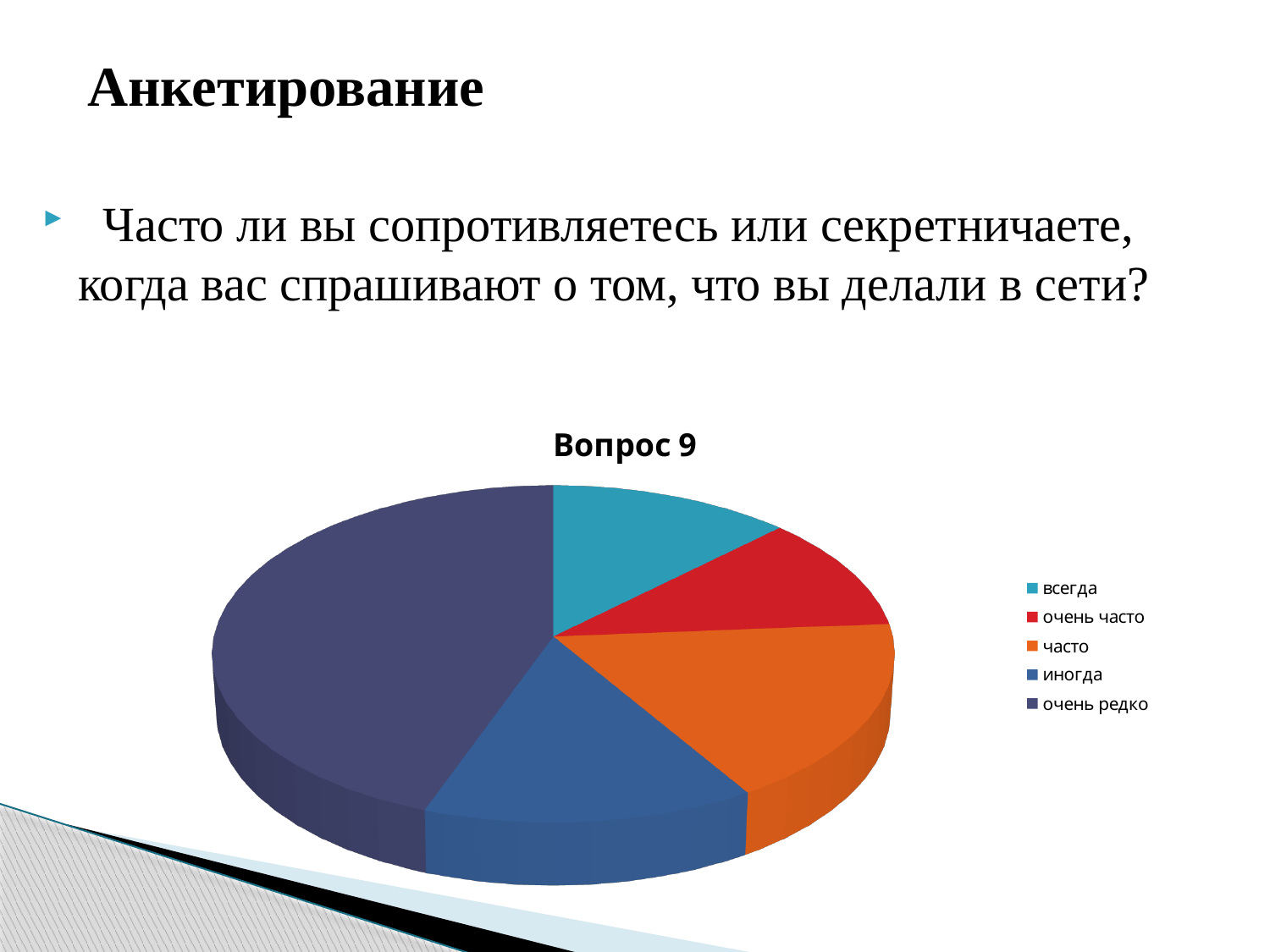
Which slice is larger, очень редко or всегда? очень редко Which category has the largest slice of the pie? очень редко How many entries does the legend list? 5 What colour is the slice for очень часто? red What kind of chart is shown on the slide? pie chart How many categories does the pie chart have? 5 What is the title of the chart? Вопрос 9 Which slice is larger, часто or очень часто? часто Which slice is larger, очень редко or иногда? очень редко